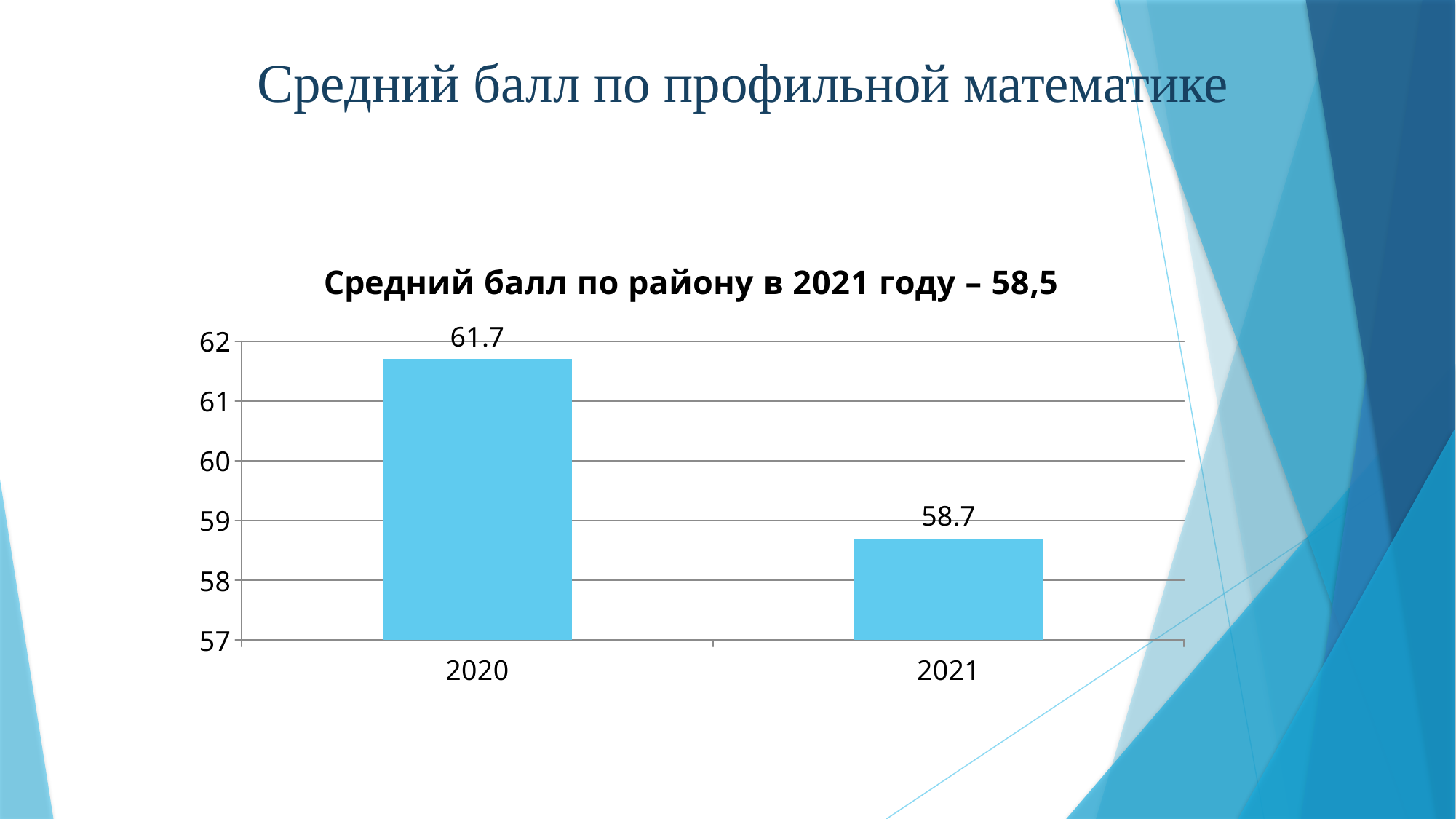
How many categories are shown on the x axis? 2 Do the values rise or fall from 2020 to 2021? fall Which year has the highest value? 2020 What is the difference between the values for 2020 and 2021? 3.0 What is the title of the chart? Средний балл по району в 2021 году – 58,5 Is the value for 2021 greater or less than 60? less Is the value for 2020 greater or less than 61? greater What is the value for 2021? 58.7 What is the value for 2020? 61.7 What kind of chart is shown on the slide? bar chart Which year has the lowest value? 2021 Which is larger, the value for 2020 or the value for 2021? 2020